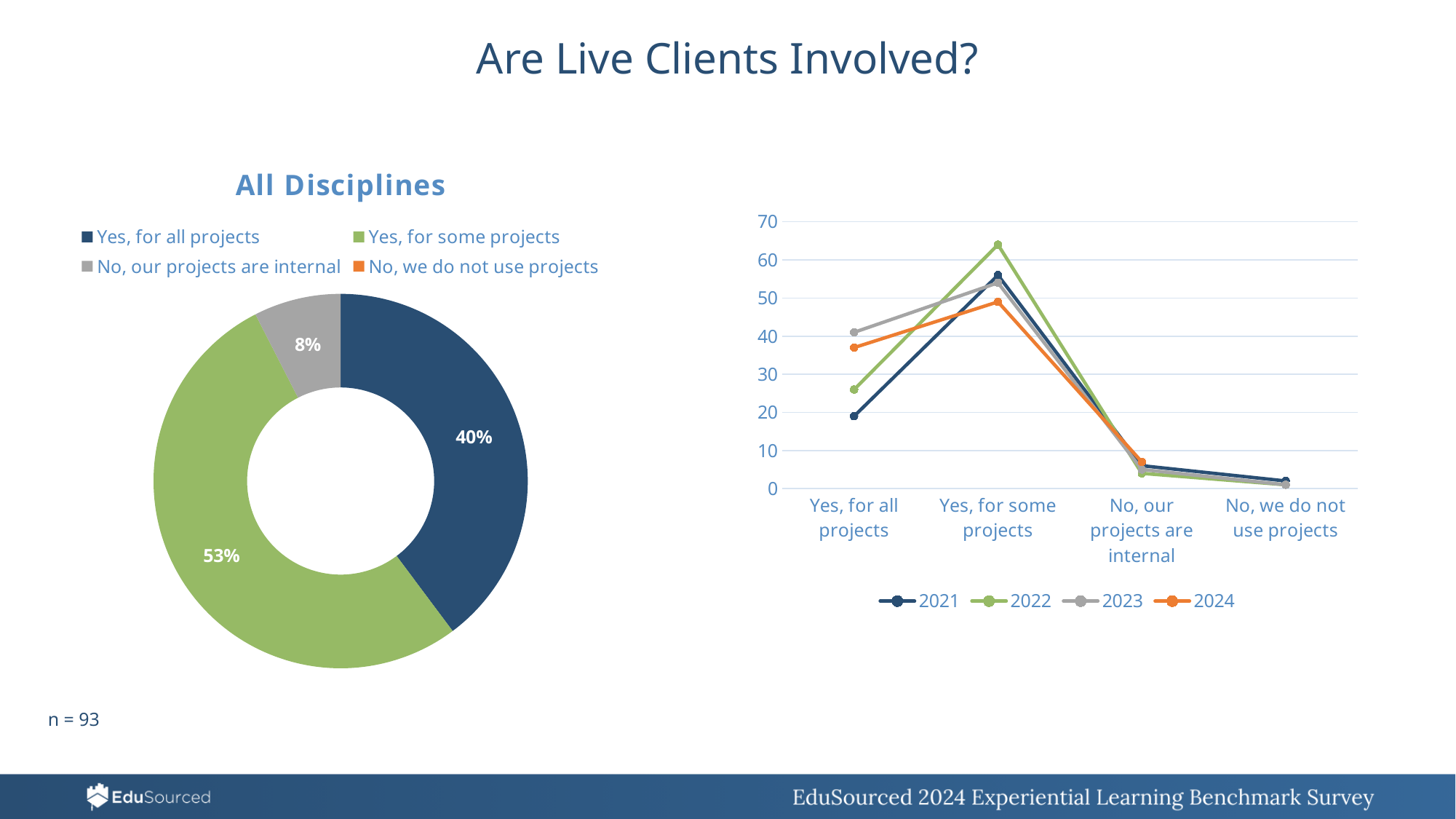
In the line chart on the right, how many categories are shown on the x axis? 4 In the line chart on the right, for "Yes, for all projects", which is larger: the 2021 value or the 2022 value? 2022 How many entries does the legend of the All Disciplines chart list? 4 In the All Disciplines donut chart, which category has the largest share? Yes, for some projects In the All Disciplines donut chart, what percentage is shown for "Yes, for some projects"? 53% What kind of chart is the All Disciplines chart on the left? Donut (pie) chart In the All Disciplines donut chart, how many percentage points larger is "Yes, for some projects" than "Yes, for all projects"? 13 percentage points In the line chart on the right, how many series does the legend list? 4 In the line chart on the right, which series has the highest value for "Yes, for some projects"? 2022 In the All Disciplines donut chart, what percentage is shown for "Yes, for all projects"? 40% In the line chart on the right, is the 2022 value for "Yes, for some projects" greater or less than 60? greater In the All Disciplines donut chart, what percentage is shown for "No, our projects are internal"? 8%